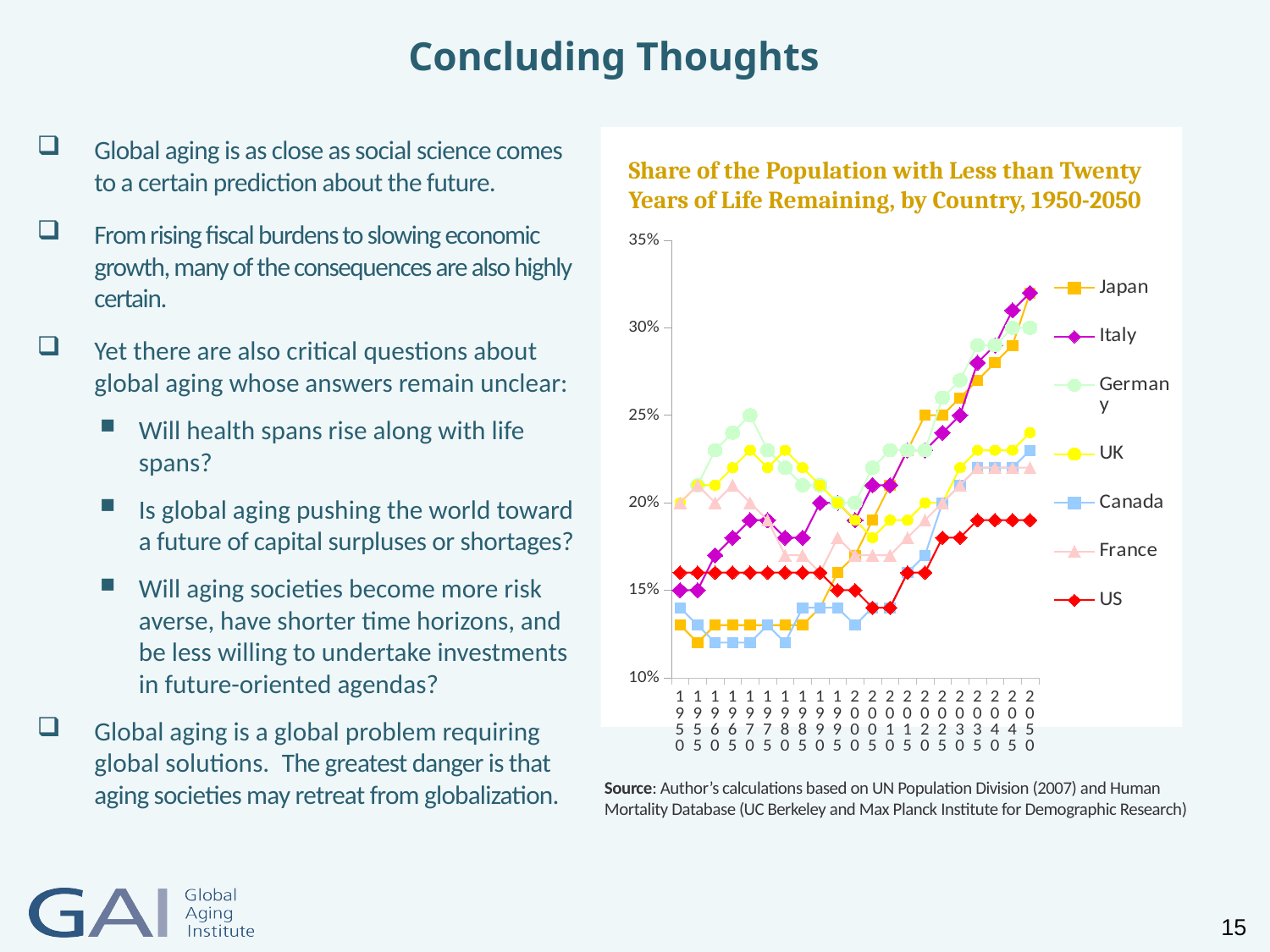
Which country has the lowest share of the population with less than twenty years of life remaining in 2050? US How many years are marked along the x axis of the chart? 21 Is the value for the US in 2050 greater or less than 20%? less In 2050, which is larger, the value for Japan or the value for the US? Japan What is the title of the chart? Share of the Population with Less than Twenty Years of Life Remaining, by Country, 1950-2050 Is the value for Japan in 2050 greater or less than 30%? greater Is the value for Canada in 1960 greater or less than 15%? less What kind of chart is shown on the slide? line chart Does the value for Japan rise or fall between 1990 and 2050? rise Which country has the highest share in 1985? UK How many countries does the chart's legend list? 7